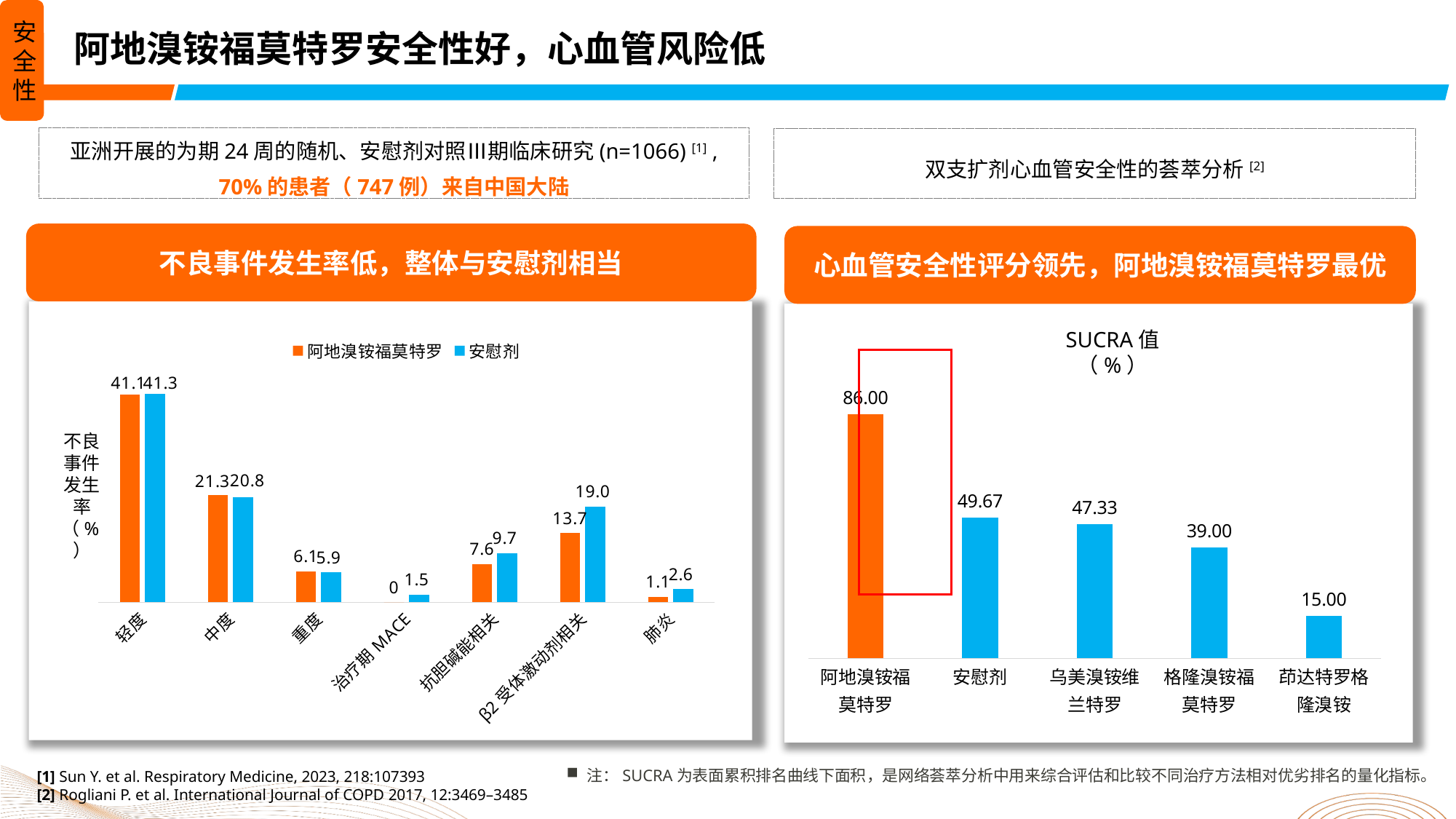
In the right chart (SUCRA 值), what is the value for 乌美溴铵维兰特罗? 47.33 In the left chart (不良事件发生率), what is the difference between 安慰剂 and 阿地溴铵福莫特罗 in the 抗胆碱能相关 category? 2.1 In the right chart (SUCRA 值), what is the difference between 阿地溴铵福莫特罗 and 安慰剂? 36.33 In the left chart (不良事件发生率), what is the value for 阿地溴铵福莫特罗 in the 中度 category? 21.3 In the left chart (不良事件发生率), how many series does the legend list? 2 In the left chart (不良事件发生率), which category has the highest value for 阿地溴铵福莫特罗? 轻度 In the right chart (SUCRA 值), which treatment has the lowest value? 茚达特罗格隆溴铵 In the left chart (不良事件发生率), how many categories are shown on the x axis? 7 What kind of chart is the right chart (SUCRA 值)? bar chart In the right chart (SUCRA 值), which is larger, the value for 安慰剂 or the value for 格隆溴铵福莫特罗? 安慰剂 In the left chart (不良事件发生率), what is the value for 阿地溴铵福莫特罗 in the 治疗期 MACE category? 0 In the left chart (不良事件发生率), what is the value for 安慰剂 in the β2受体激动剂相关 category? 19.0